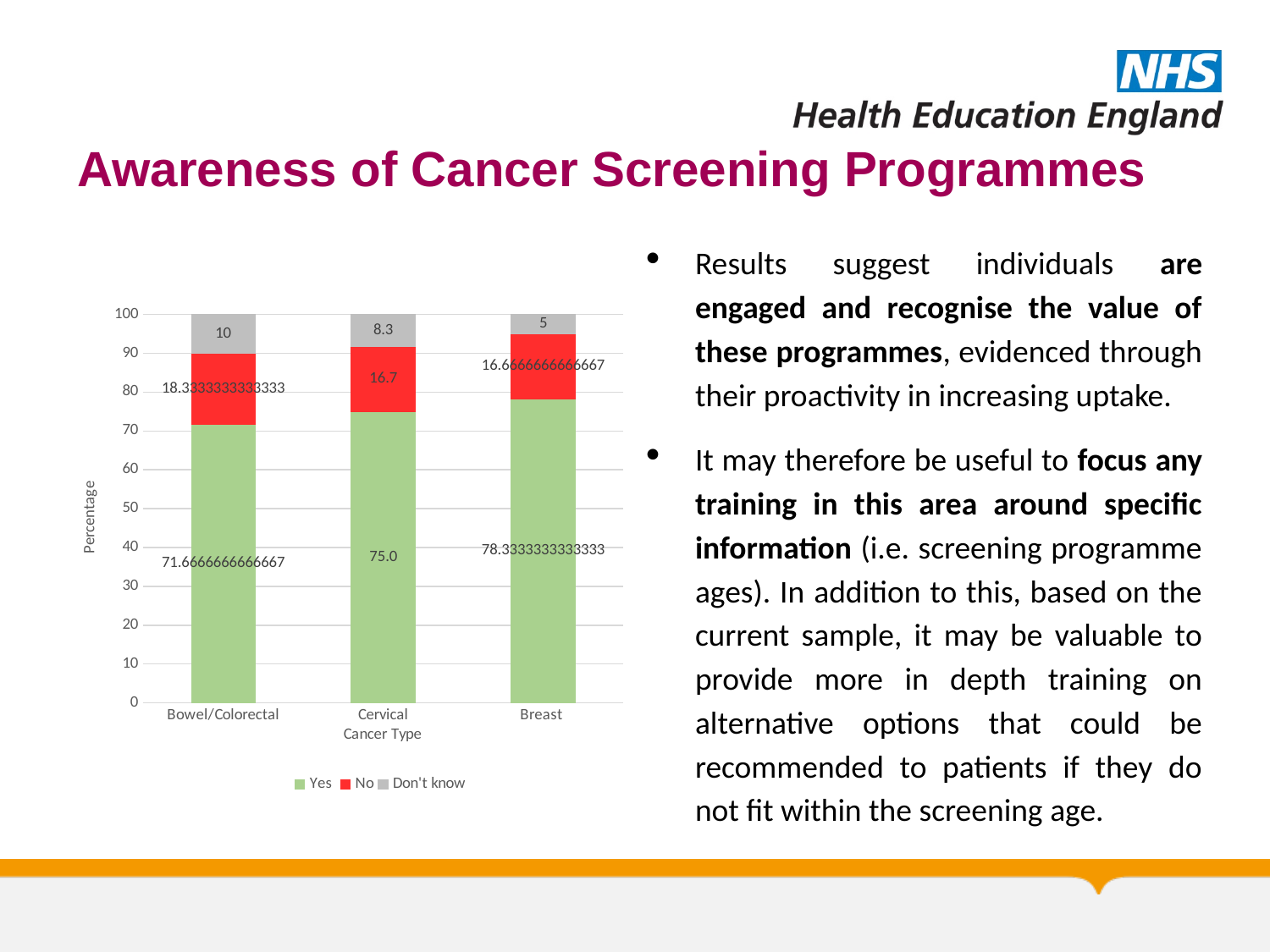
Which cancer type has the lowest 'Don't know' value? Breast Which cancer type has the highest 'Yes' value? Breast What is the difference between the 'Don't know' values for Bowel/Colorectal and Breast? 5 How many cancer types are shown on the x axis of the chart? 3 What is the 'No' value for Cervical? 16.7 What kind of chart is shown on the slide? Stacked bar chart Is the 'Yes' value for Bowel/Colorectal greater or less than 70? greater How many series does the chart legend list? 3 What is the 'Don't know' value for Bowel/Colorectal? 10 What is the label on the y axis of the chart? Percentage What is the 'Yes' value for Cervical? 75.0 What is the 'Don't know' value for Breast? 5